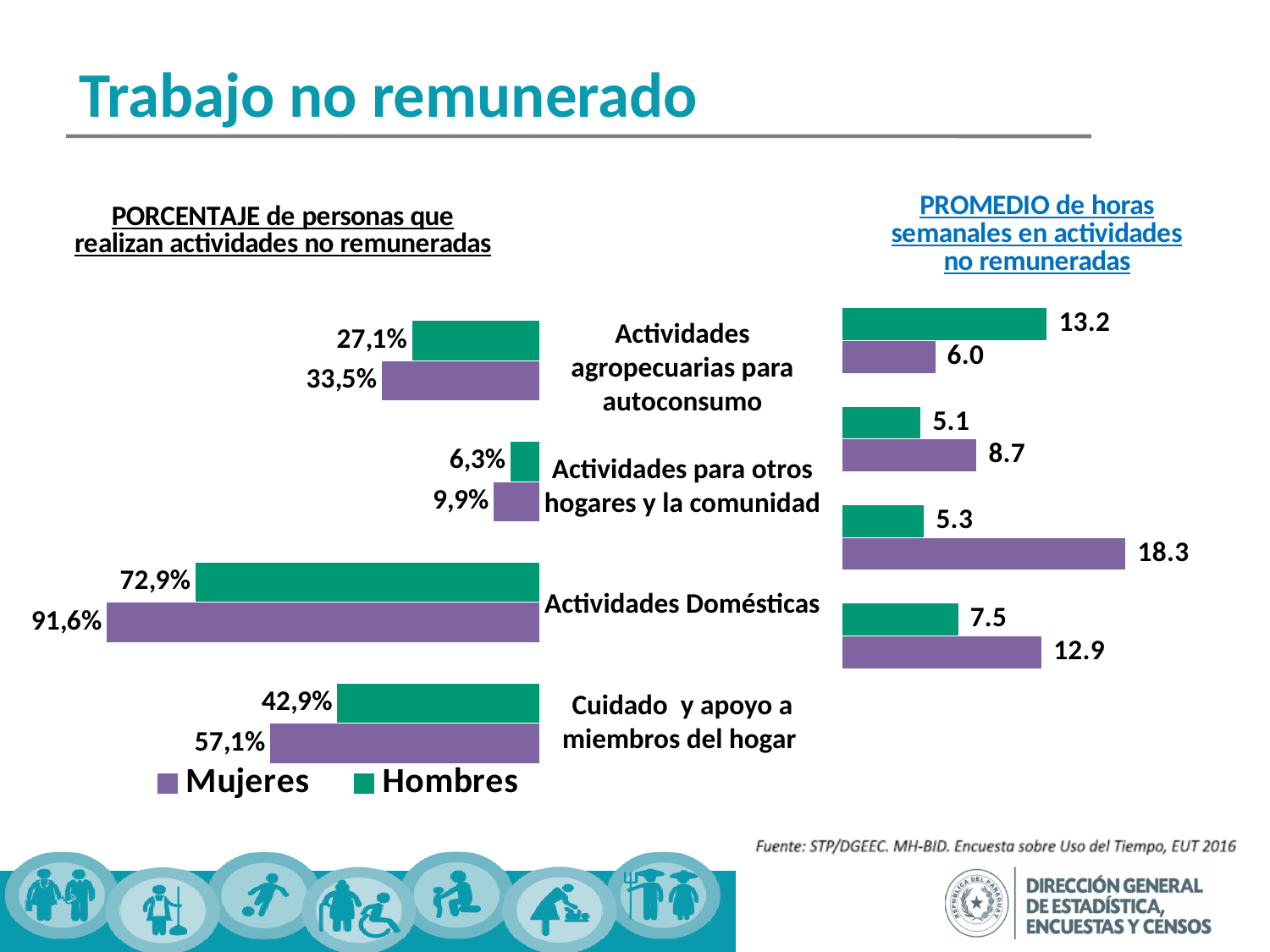
In the chart 'PROMEDIO de horas semanales en actividades no remuneradas', what is the difference between Mujeres and Hombres in Actividades Domésticas? 13.0 In the chart 'PROMEDIO de horas semanales en actividades no remuneradas', what is the value for Hombres in Actividades agropecuarias para autoconsumo? 13.2 In the chart 'PROMEDIO de horas semanales en actividades no remuneradas', what is the value for Mujeres in Actividades Domésticas? 18.3 How many activity categories are shown in the chart 'PORCENTAJE de personas que realizan actividades no remuneradas'? 4 What kind of chart is 'PROMEDIO de horas semanales en actividades no remuneradas'? Bar chart In the chart 'PORCENTAJE de personas que realizan actividades no remuneradas', what is the difference between Mujeres and Hombres in Cuidado y apoyo a miembros del hogar? 14,2% In the chart 'PROMEDIO de horas semanales en actividades no remuneradas', which activity has the highest value for Mujeres? Actividades Domésticas How many series does the legend of the chart 'PORCENTAJE de personas que realizan actividades no remuneradas' list? 2 In the chart 'PORCENTAJE de personas que realizan actividades no remuneradas', what is the value for Mujeres in Actividades Domésticas? 91,6% In the chart 'PROMEDIO de horas semanales en actividades no remuneradas', which is larger for Actividades agropecuarias para autoconsumo: Mujeres or Hombres? Hombres In the chart 'PORCENTAJE de personas que realizan actividades no remuneradas', what is the value for Hombres in Cuidado y apoyo a miembros del hogar? 42,9% In the chart 'PORCENTAJE de personas que realizan actividades no remuneradas', which activity has the lowest value for Hombres? Actividades para otros hogares y la comunidad